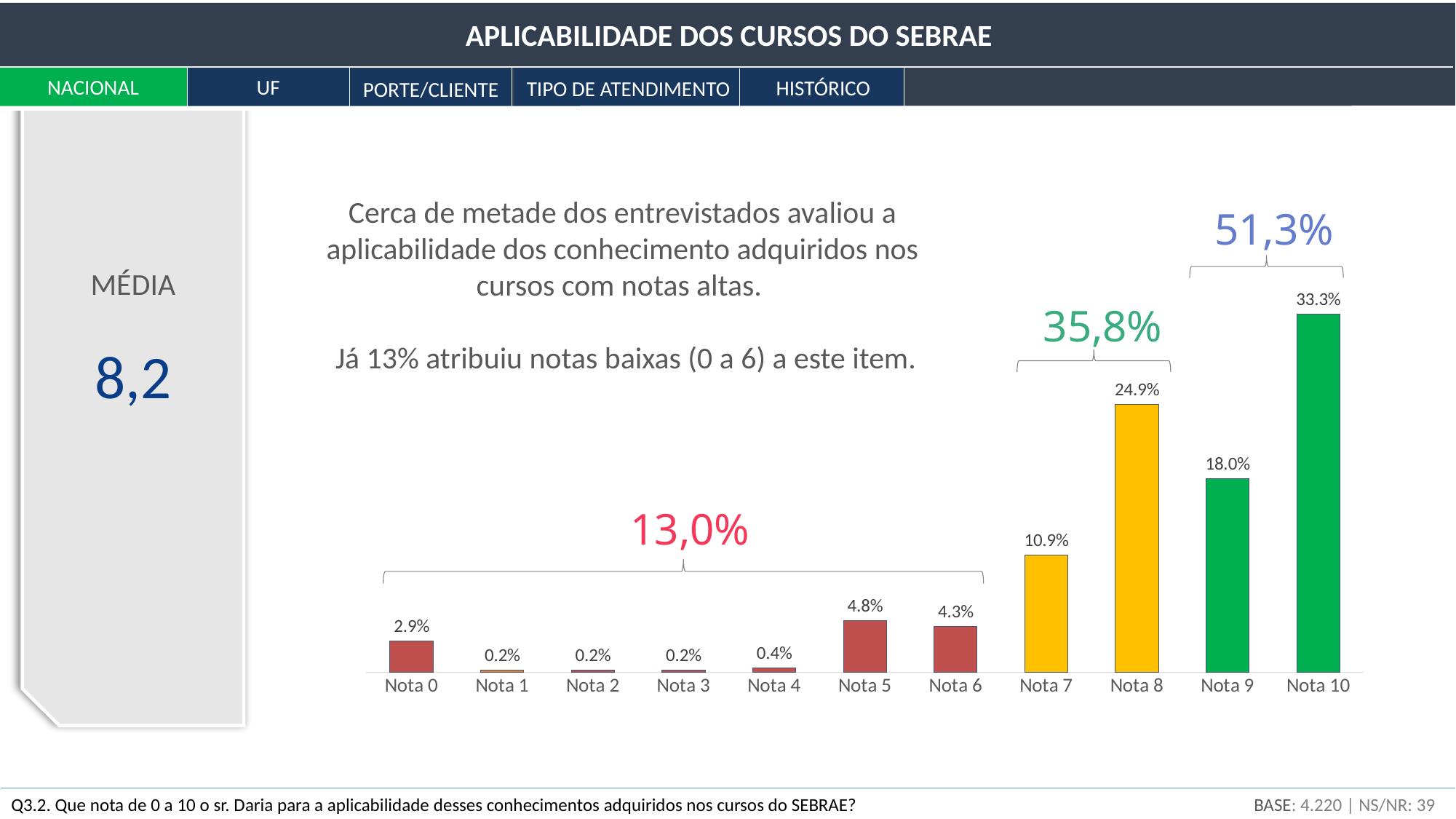
What percentage is shown above the bracket grouping Nota 7 and Nota 8? 35,8% Which category has the highest value? Nota 10 How many categories are shown on the x axis? 11 What colour are the bars for Nota 9 and Nota 10? Green What is the value for Nota 8? 24.9% What kind of chart is shown on the slide? Bar chart What is the difference between the values for Nota 8 and Nota 7? 14.0% What is the value for Nota 5? 4.8% Which is larger, the value for Nota 5 or the value for Nota 6? Nota 5 What is the value for Nota 10? 33.3% What is the difference between the values for Nota 10 and Nota 9? 15.3% Which is larger, the value for Nota 0 or the value for Nota 4? Nota 0